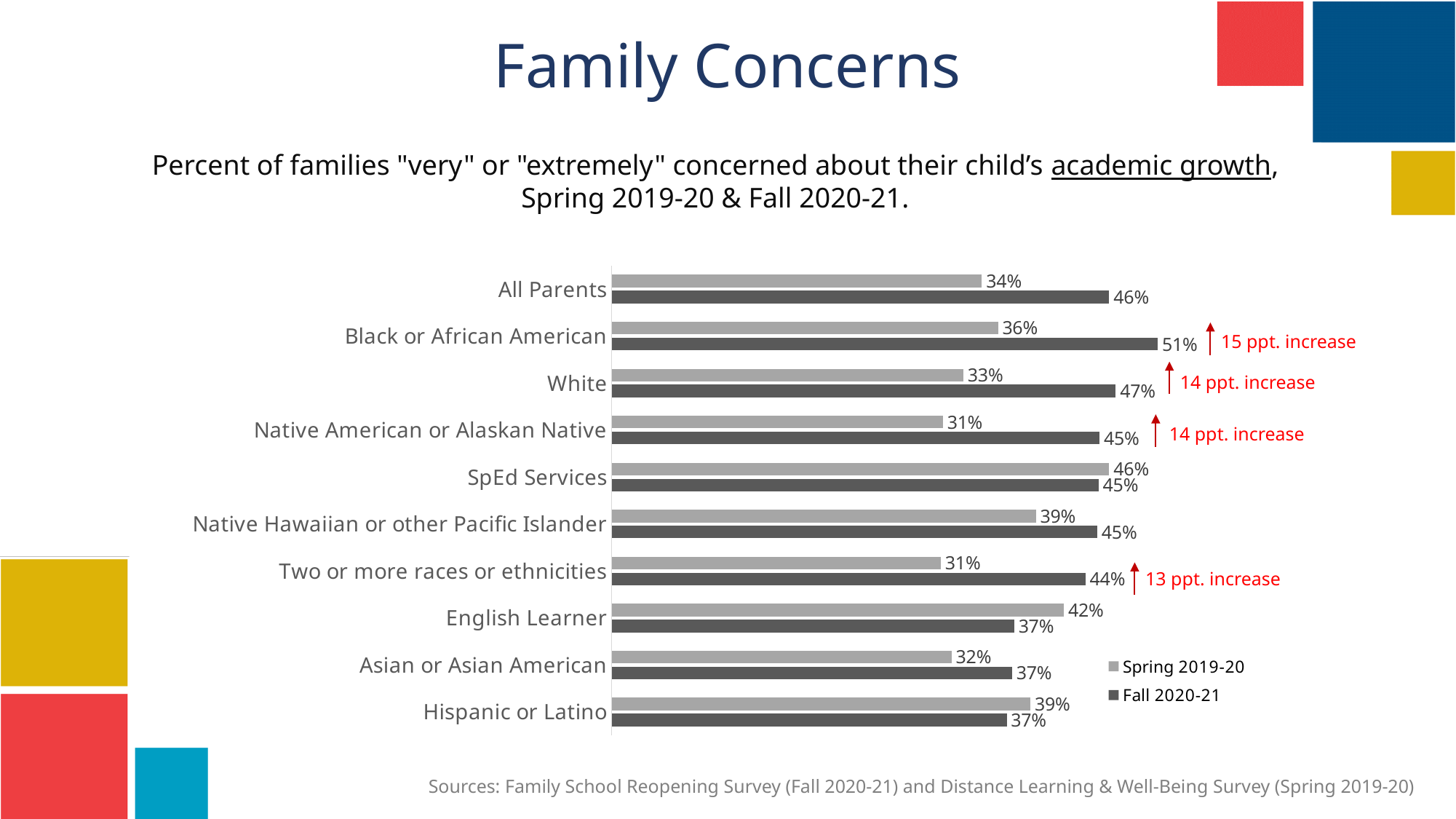
Which category has the highest Fall 2020-21 value? Black or African American What is the difference between the Fall 2020-21 and Spring 2019-20 values for White families? 14 percentage points How many series does the legend list? 2 What is the Spring 2019-20 value for SpEd Services? 46% What is the Fall 2020-21 value for All Parents? 46% What is the Fall 2020-21 value for Black or African American families? 51% Which category has the lowest Spring 2019-20 value? Native American or Alaskan Native and Two or more races or ethnicities (both 31%) What kind of chart is shown on the slide? Bar chart How many categories are shown on the chart? 10 What are the two series listed in the legend? Spring 2019-20 and Fall 2020-21 What is the Spring 2019-20 value for English Learner families? 42% Which is larger for English Learner families: the Spring 2019-20 value or the Fall 2020-21 value? Spring 2019-20